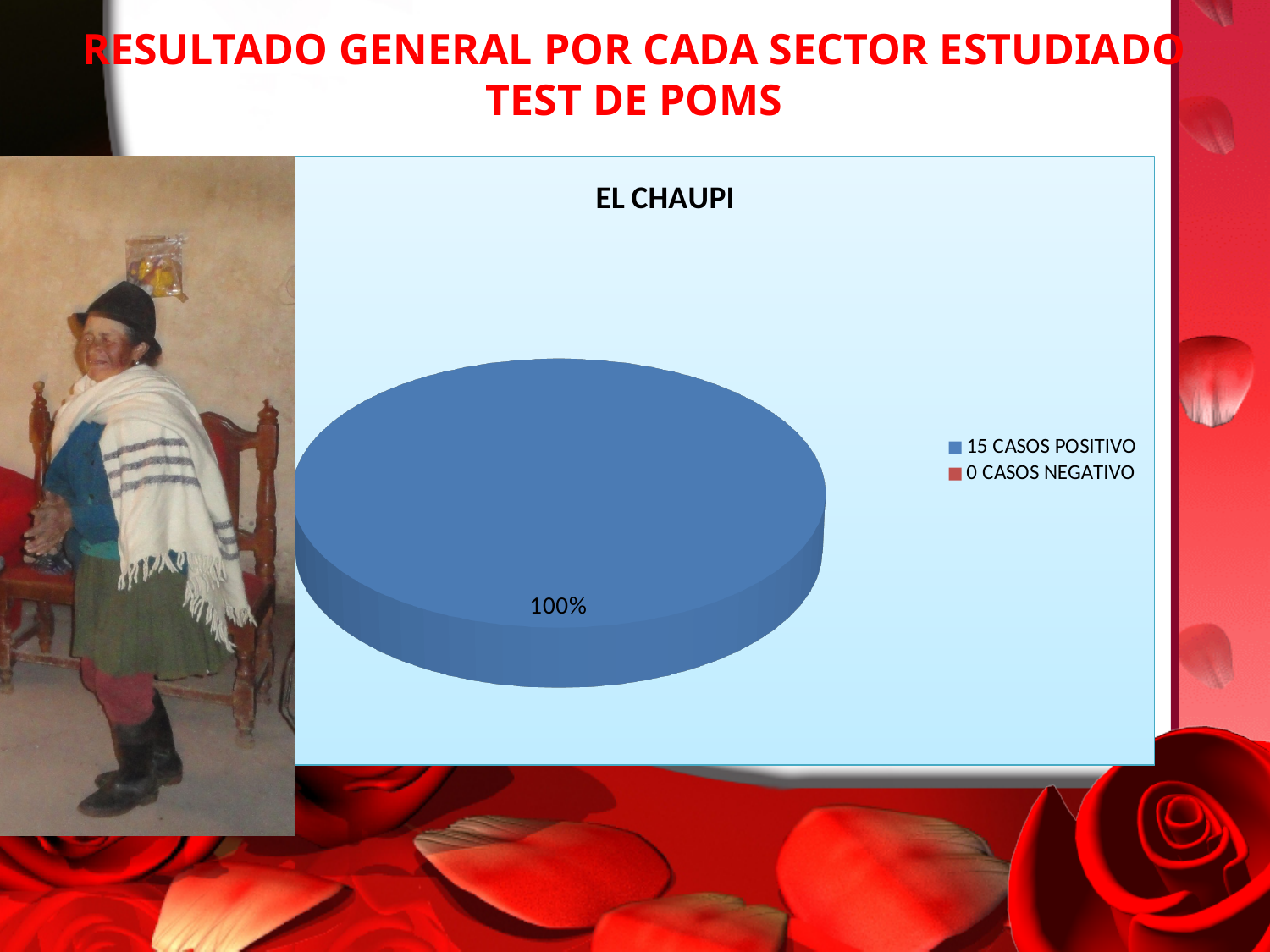
Which is larger, the share for '15 CASOS POSITIVO' or for '0 CASOS NEGATIVO'? 15 CASOS POSITIVO What colour is the '15 CASOS POSITIVO' slice in the legend? blue What kind of chart is shown on the slide? pie chart Which legend category has the smallest share of the pie? 0 CASOS NEGATIVO What percentage label is printed on the pie? 100% Which legend category accounts for the whole pie? 15 CASOS POSITIVO How many entries does the chart legend list? 2 What share of the pie does the '15 CASOS POSITIVO' slice take? 100% What is the title of the chart? EL CHAUPI